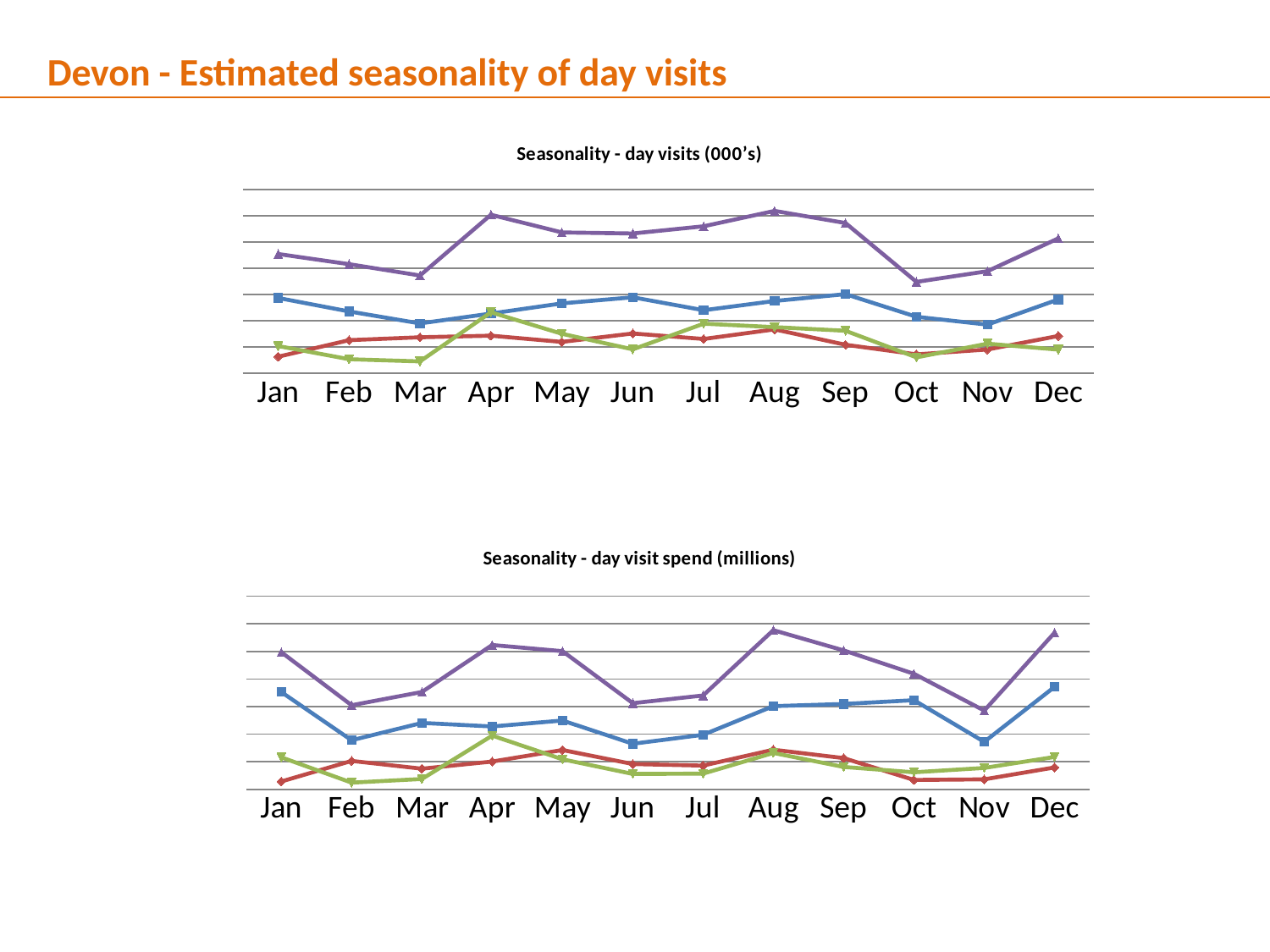
In the bottom chart, in which month does the green line reach its highest point? Apr In the top chart, in which month does the green line reach its highest point? Apr In the bottom chart, which line is higher in Jun, the purple line or the blue line? Purple What is the title of the bottom chart? Seasonality - day visit spend (millions) In the top chart, in which month does the purple line reach its highest point? Aug What kind of chart is the top chart titled "Seasonality - day visits (000's)"? Line chart In the bottom chart, how many lines are plotted? 4 In the top chart, in which month does the purple line reach its lowest point? Oct In the top chart, does the purple line rise or fall from Sep to Oct? Fall In the top chart, in which month does the blue line reach its lowest point? Nov What kind of chart is the bottom chart titled "Seasonality - day visit spend (millions)"? Line chart In the top chart, how many months are shown on the x axis? 12